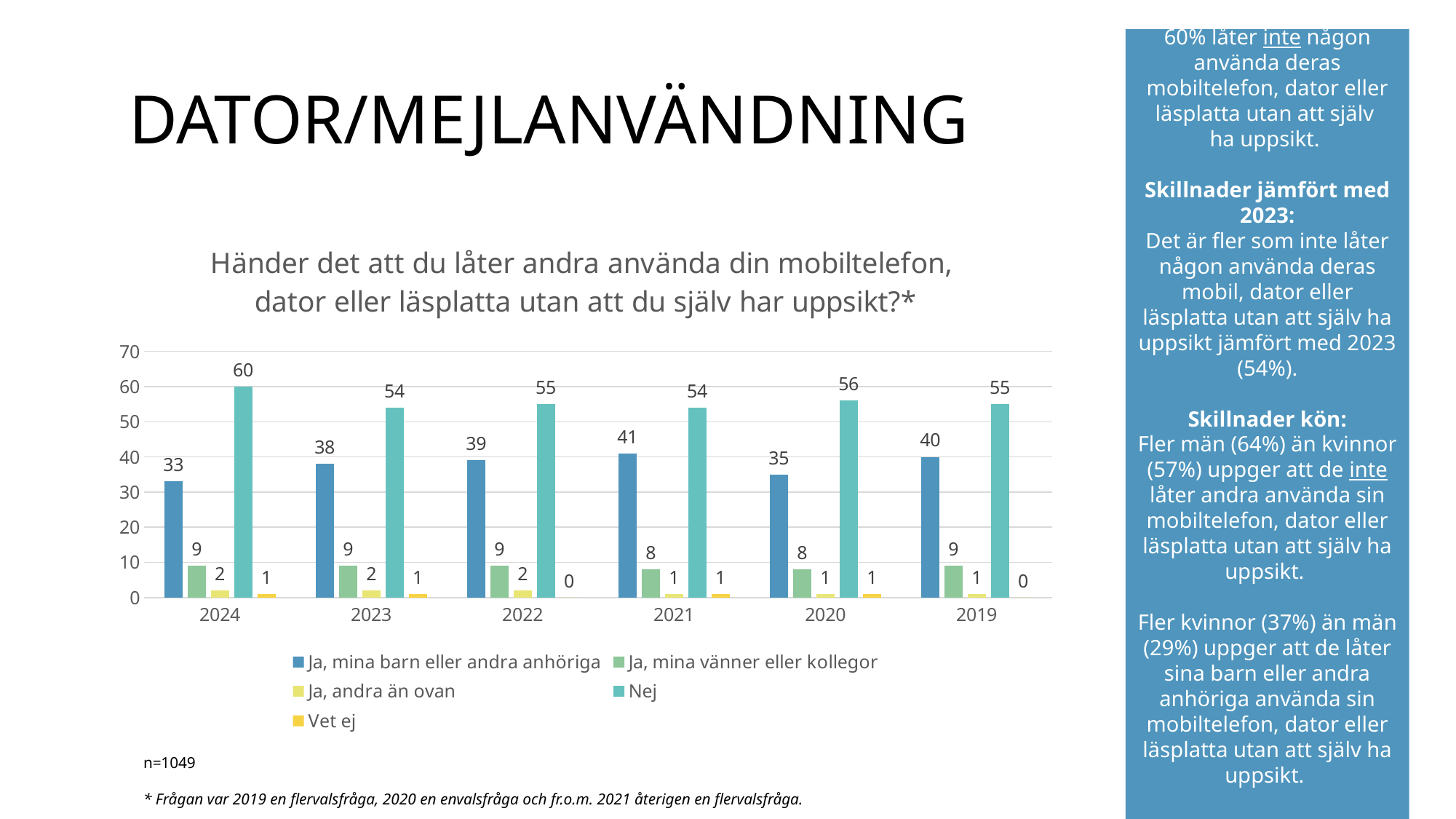
What kind of chart is shown on the slide? bar chart What is the value for "Ja, mina barn eller andra anhöriga" in 2021? 41 How many series does the legend list? 5 How many years are shown on the x axis? 6 What is the difference between the "Nej" values for 2024 and 2023? 6 In which year is the value for "Ja, mina barn eller andra anhöriga" lowest? 2024 What sample size (n) is stated below the chart? n=1049 What is the value for "Ja, mina vänner eller kollegor" in 2020? 8 Is the value for "Nej" in 2022 greater or less than 50? greater Which is larger: the value for "Ja, mina barn eller andra anhöriga" in 2019 or in 2020? 2019 In which year is the value for "Nej" highest? 2024 What is the value for "Nej" in 2024? 60